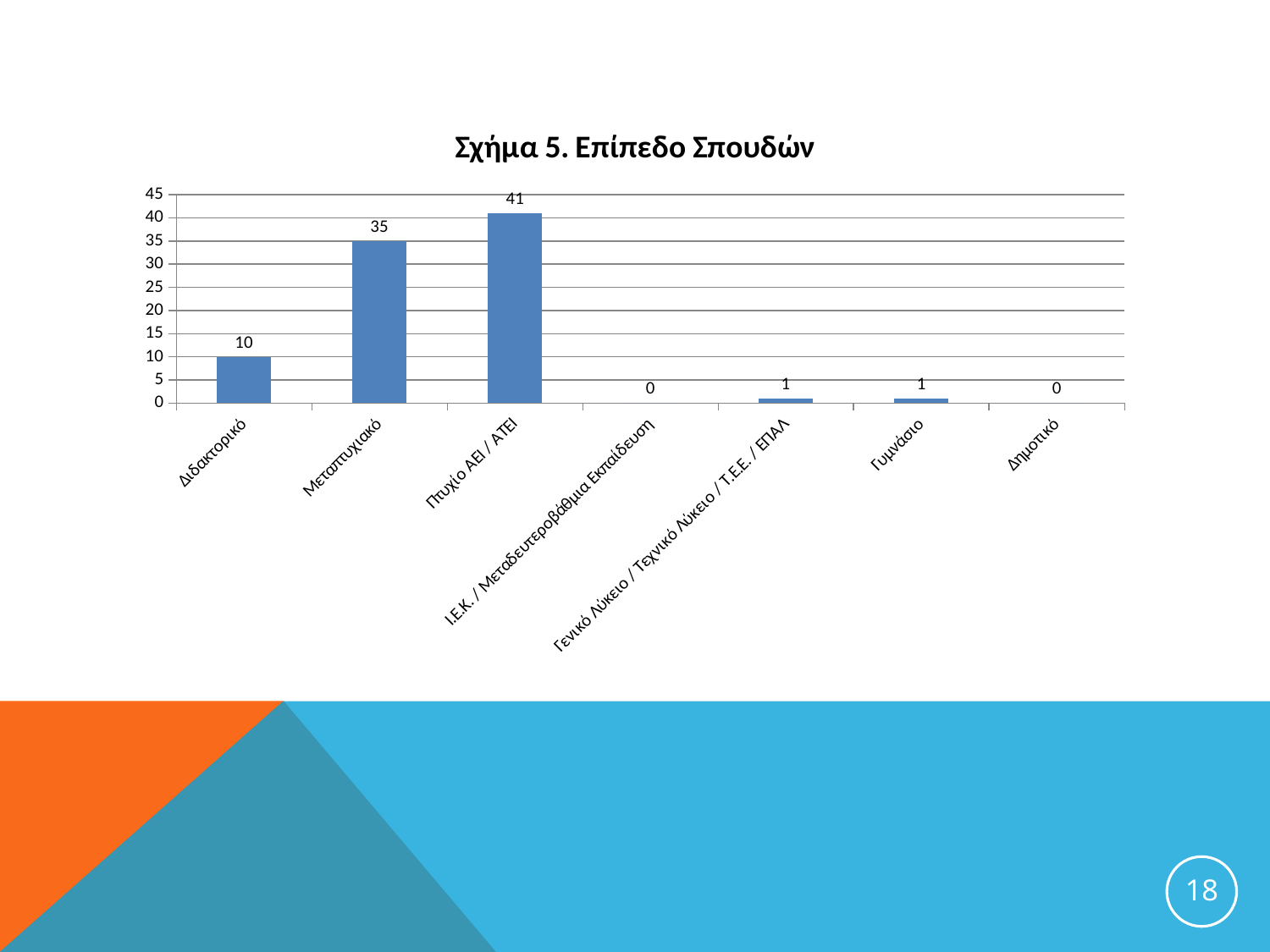
What is the value for Πτυχίο ΑΕΙ / ΑΤΕΙ? 41 What is the value for Μεταπτυχιακό? 35 What is the difference between the values for Πτυχίο ΑΕΙ / ΑΤΕΙ and Μεταπτυχιακό? 6 What is the value for Δημοτικό? 0 What is the value for Διδακτορικό? 10 Which category has the highest value? Πτυχίο ΑΕΙ / ΑΤΕΙ What is the value for Γυμνάσιο? 1 What kind of chart is shown on the slide? Bar chart What is the difference between the values for Μεταπτυχιακό and Διδακτορικό? 25 What is the title of the chart? Σχήμα 5. Επίπεδο Σπουδών How many categories are shown on the x axis? 7 Which is larger, the value for Διδακτορικό or the value for Μεταπτυχιακό? Μεταπτυχιακό